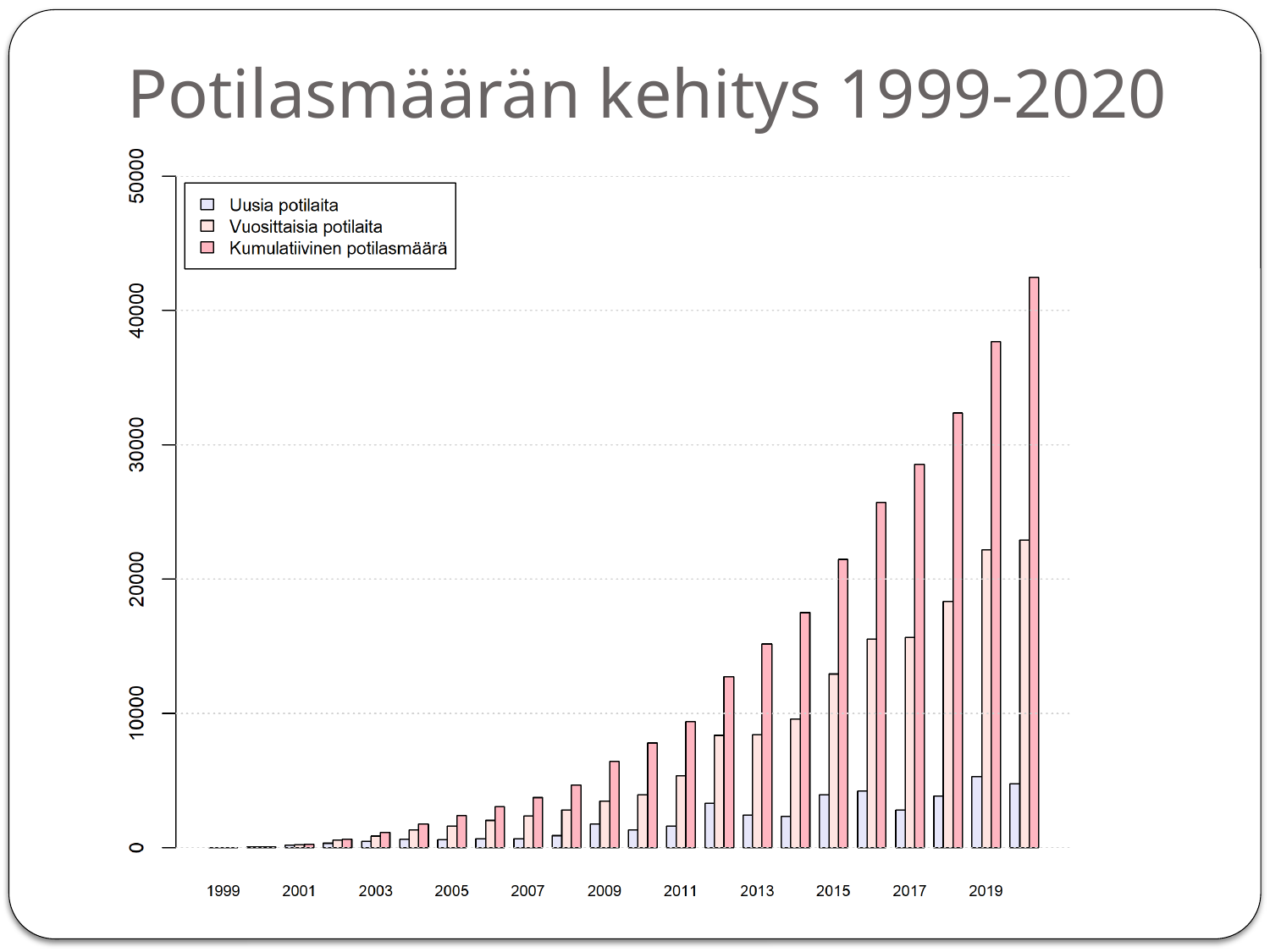
Is the Kumulatiivinen potilasmäärä value for 2018 greater or less than 30000? greater Is the Vuosittaisia potilaita value for 2020 greater or less than 20000? greater Which series is shown in the darkest pink/red bars according to the legend? Kumulatiivinen potilasmäärä Does the Kumulatiivinen potilasmäärä series rise or fall from 1999 to 2020? rise Is the Kumulatiivinen potilasmäärä value for 2020 greater or less than 40000? greater How many series does the legend list? 3 In which year is the Kumulatiivinen potilasmäärä bar highest? 2020 How many years are plotted on the x axis? 22 What is the title of the chart? Potilasmäärän kehitys 1999-2020 What kind of chart is shown on the slide? bar chart